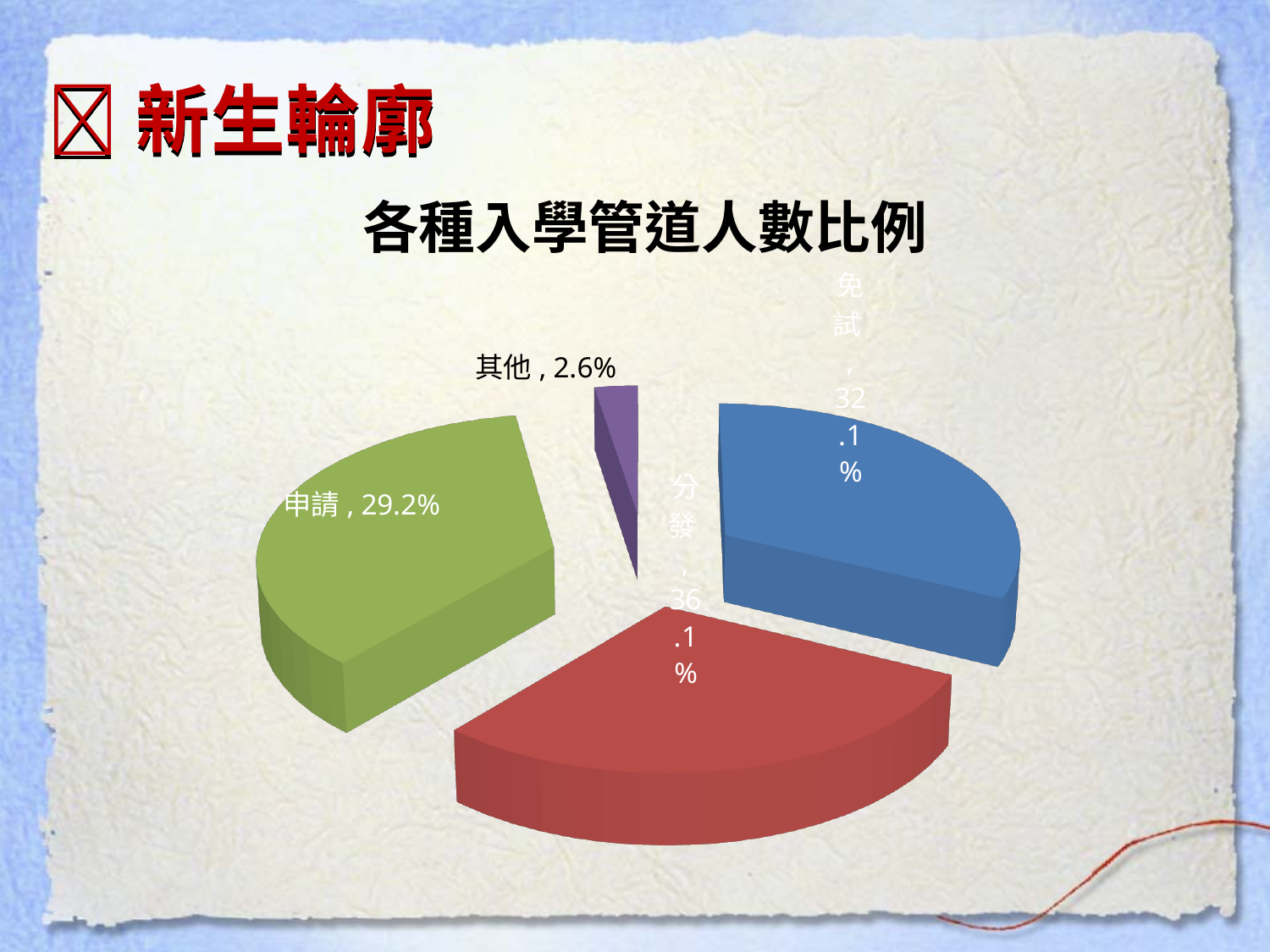
What percentage is shown for 申請? 29.2% What colour is the slice for 申請? green What is the difference between the shares for 分發 and 申請? 6.9% What kind of chart is shown on the slide? pie chart What percentage is shown for 分發? 36.1% Which category has the largest share of the pie? 分發 Which category has the smallest share of the pie? 其他 How many slices does the pie chart have? 4 What percentage is shown for 其他? 2.6% What is the title of the chart? 各種入學管道人數比例 What percentage is shown for 免試? 32.1% Which is larger, the share for 申請 or the share for 免試? 免試